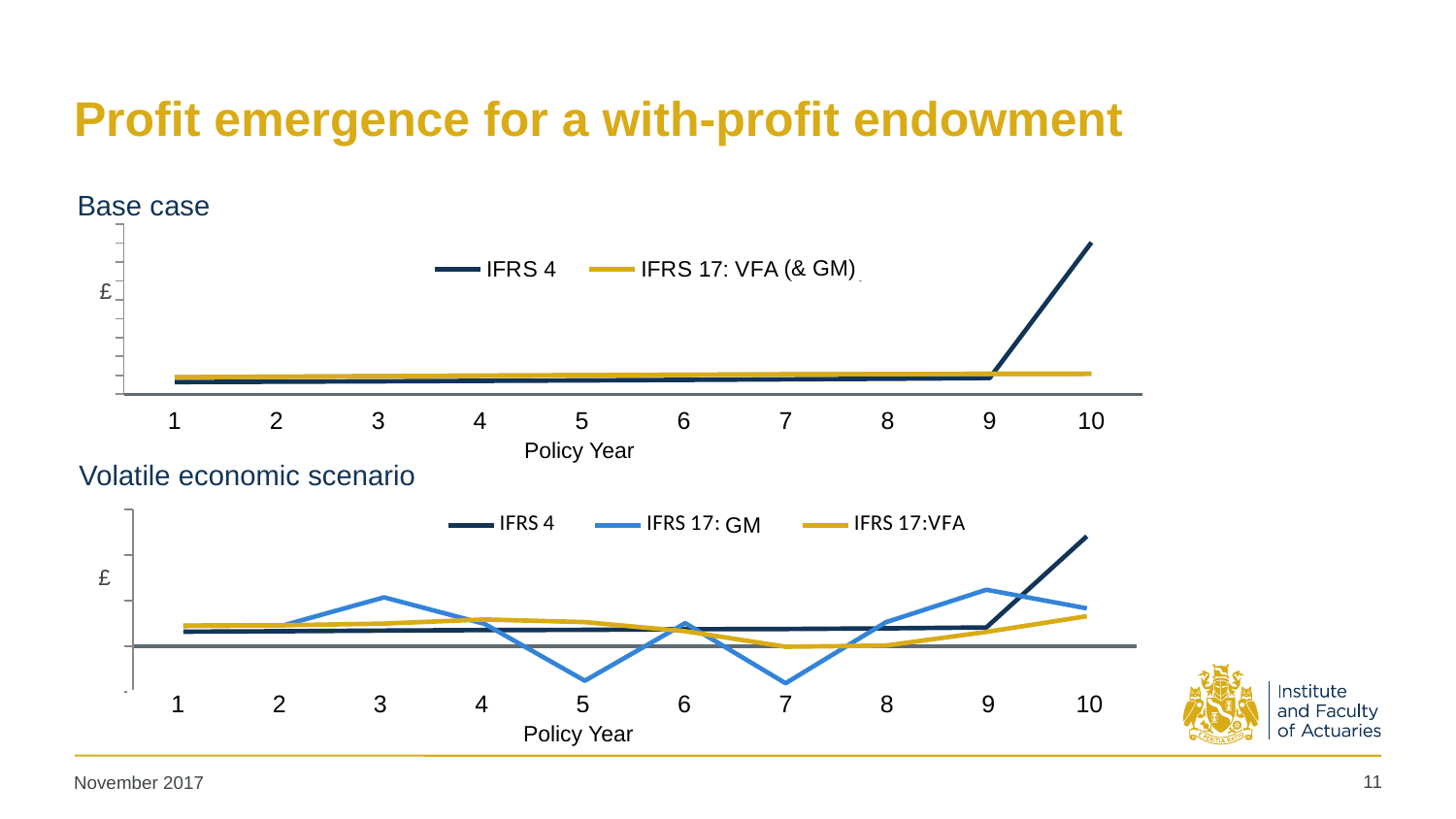
How many policy years are shown on the x axis of the 'Volatile economic scenario' chart? 10 In the 'Base case' chart, does the IFRS 4 line rise or fall between policy year 9 and policy year 10? rise How many series does the legend of the 'Base case' chart list? 2 How many series does the legend of the 'Volatile economic scenario' chart list? 3 In the 'Base case' chart, at policy year 10, which series has the larger value: IFRS 4 or IFRS 17: VFA (& GM)? IFRS 4 In the 'Volatile economic scenario' chart, at policy year 10, which series has the larger value: IFRS 4 or IFRS 17:VFA? IFRS 4 In the 'Base case' chart, in which policy year is the IFRS 4 value highest? 10 What kind of chart is the 'Volatile economic scenario' chart? line chart What is the label on the x axis of the 'Volatile economic scenario' chart? Policy Year What kind of chart is the 'Base case' chart? line chart How many policy years are shown on the x axis of the 'Base case' chart? 10 In the 'Volatile economic scenario' chart, in which policy year is the IFRS 4 value highest? 10